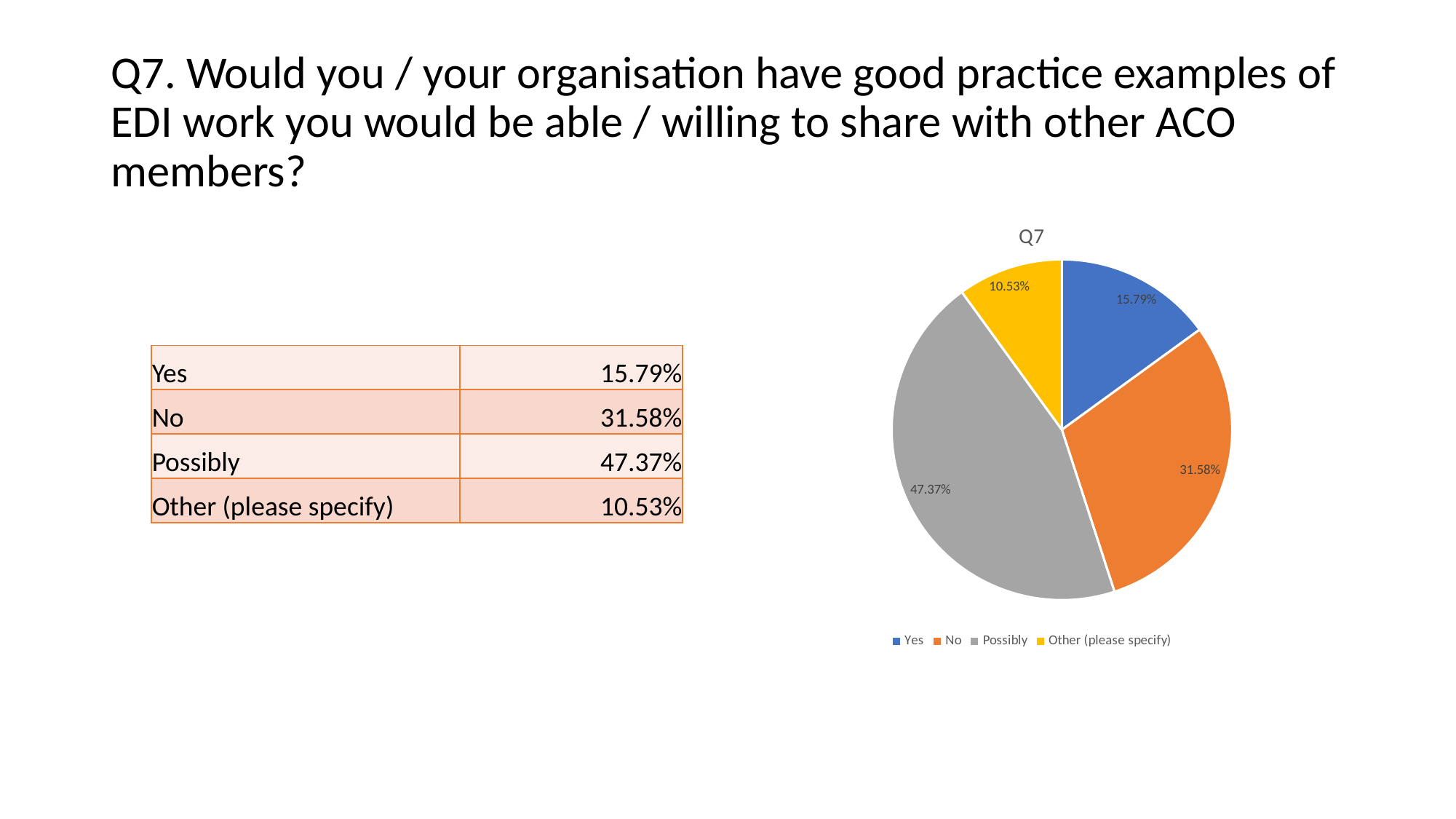
Which category has the smallest slice of the pie? Other (please specify) Which category has the largest slice of the pie? Possibly What is the difference in percentage points between the Possibly slice and the No slice? 15.79 Which is larger, the No slice or the Yes slice? No What percentage of the pie does the Yes slice represent? 15.79% How many categories does the legend list? 4 What percentage of the pie does the Other (please specify) slice represent? 10.53% What is the title of the chart? Q7 What percentage of the pie does the Possibly slice represent? 47.37% What percentage of the pie does the No slice represent? 31.58% What kind of chart is shown on the slide? pie chart What colour is the Possibly slice? grey